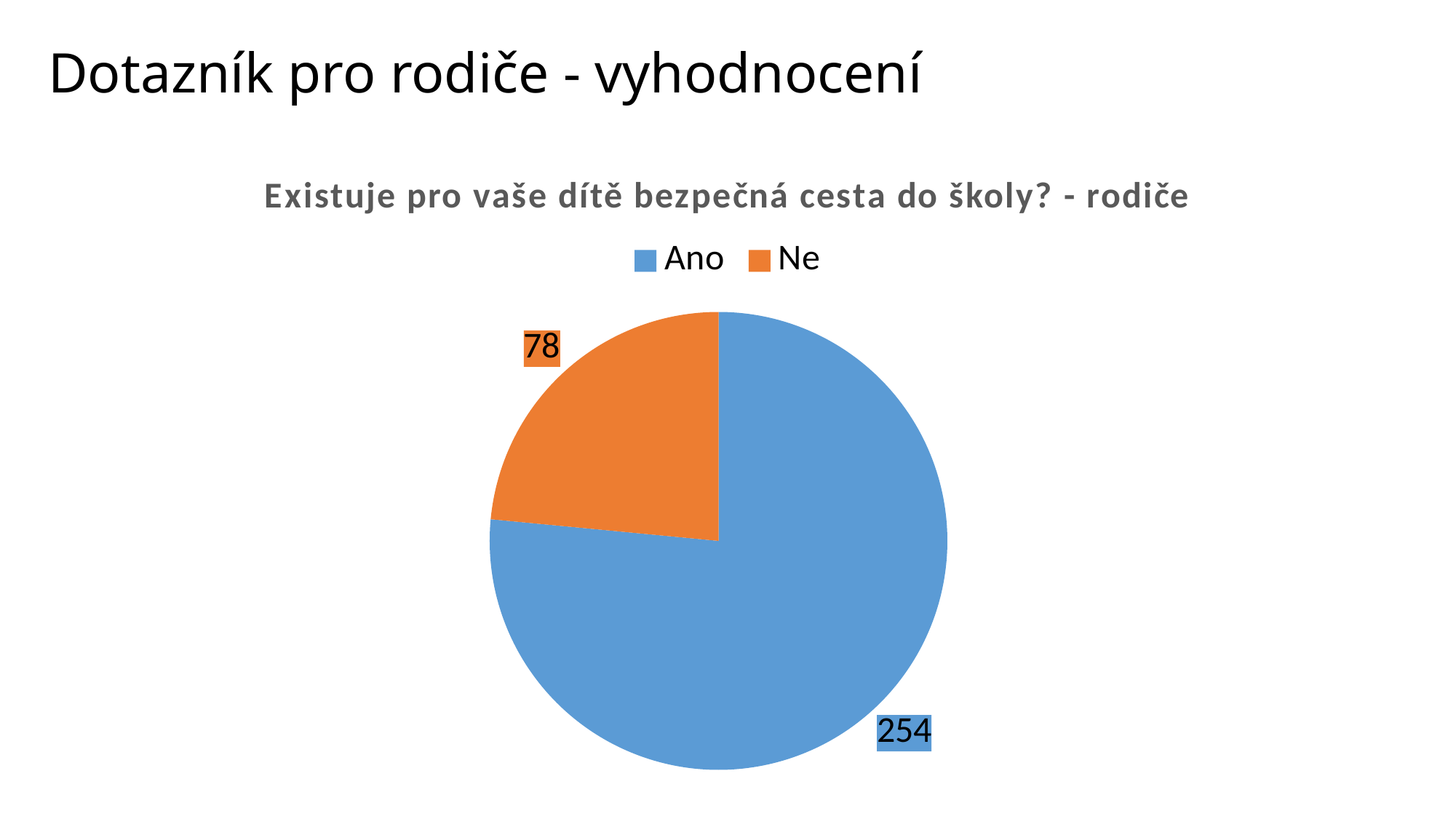
What kind of chart is shown on the slide? pie chart What share of the pie does the Ano slice represent, to one decimal place? 76.5% What is the value for Ano in the pie chart? 254 What is the total of all slices in the pie chart? 332 What is the title of the pie chart? Existuje pro vaše dítě bezpečná cesta do školy? - rodiče Which category has the largest slice in the pie chart? Ano What colour is the Ne slice in the pie chart? orange What is the difference between the values for Ano and Ne? 176 What is the value for Ne in the pie chart? 78 Which is larger, the value for Ano or the value for Ne? Ano Which category has the smallest slice in the pie chart? Ne How many categories does the pie chart show? 2